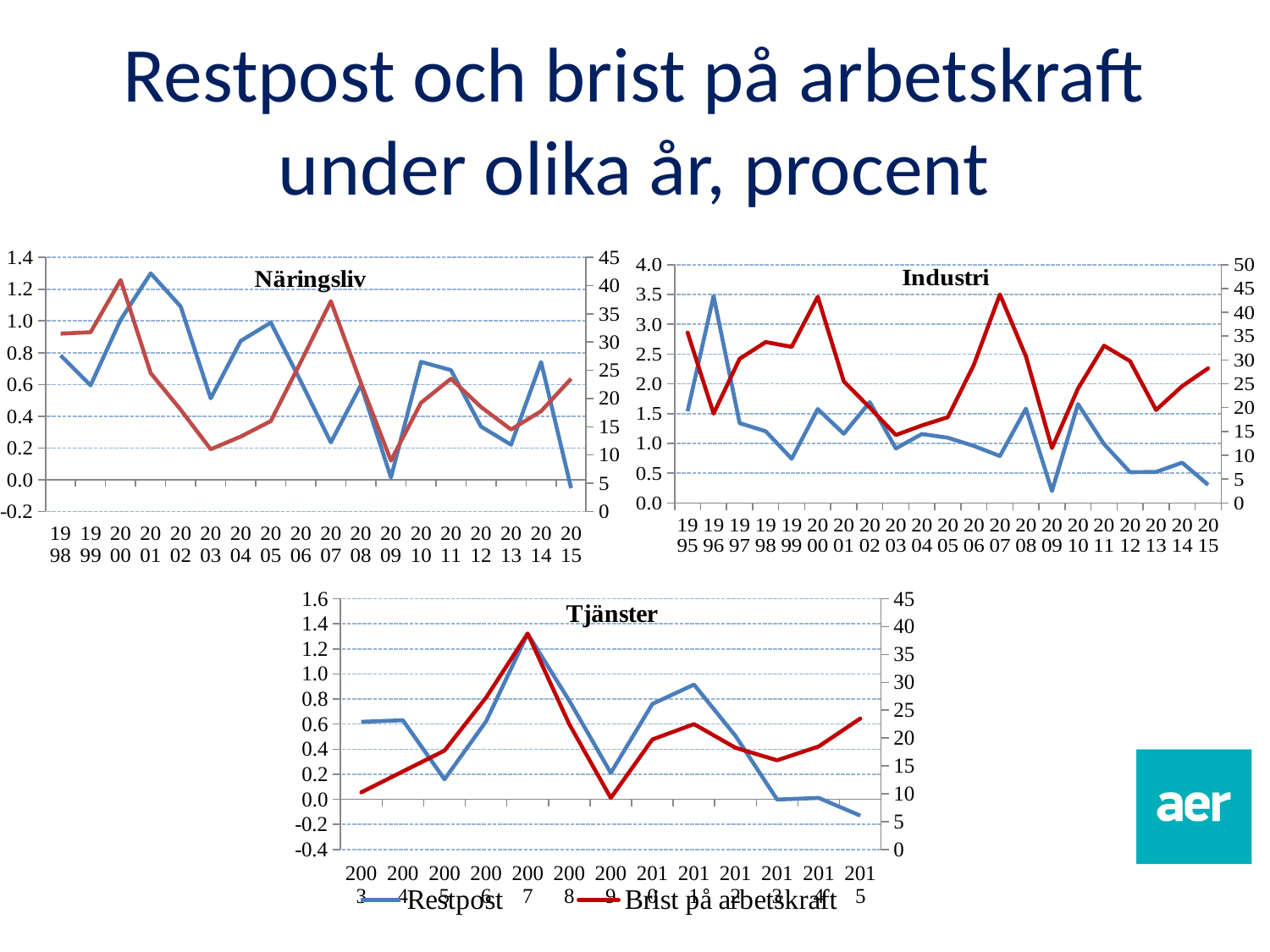
What are the two series named in the legend? Restpost and Brist på arbetskraft How many series does the legend list? 2 In the Tjänster chart, which year has the highest Restpost value? 2007 How many charts are shown on the slide? 3 In the Näringsliv chart, is the Restpost value for 2001 greater or less than 1.0? greater What type of chart is the Näringsliv chart? line chart In the Tjänster chart, does the Restpost line rise or fall from 2011 to 2015? fall In the Industri chart, which year has the lowest Restpost value? 2009 In the Industri chart, is the Restpost value for 1996 greater or less than 3.0? greater In the Industri chart, which year has the highest Restpost value? 1996 In the Industri chart, how many years are shown on the x axis? 21 In the Tjänster chart, how many years are shown on the x axis? 13